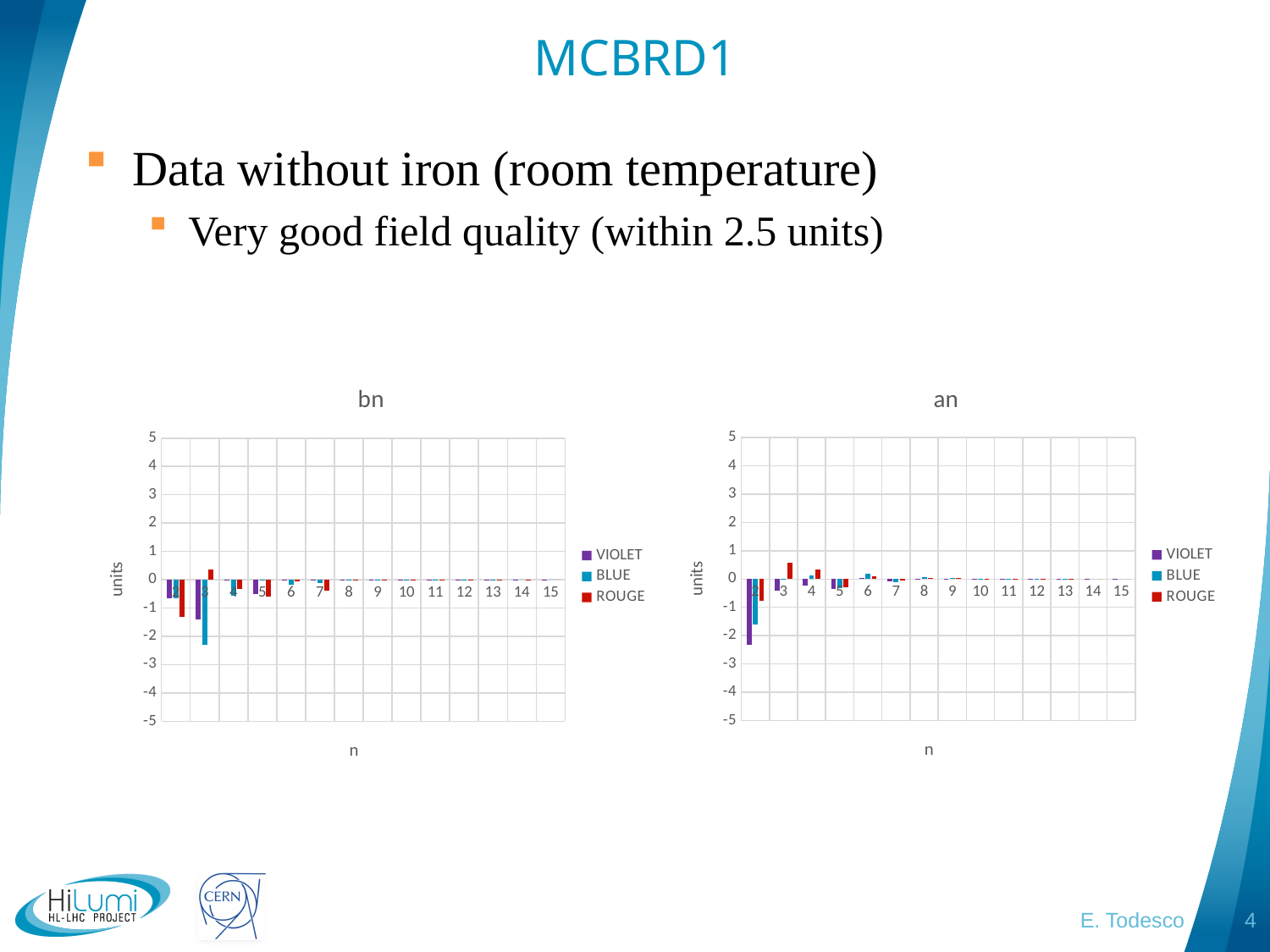
In the chart titled "bn", at n = 3, which is larger: the BLUE value or the ROUGE value? ROUGE In the chart titled "an", what is the label of the x axis? n In the chart titled "bn", what is the label of the y axis? units In the chart titled "bn", is the ROUGE value at n = 2 greater or less than -1? less What kind of chart is the chart titled "bn"? bar chart In the chart titled "an", is the BLUE value at n = 2 greater or less than -1? less In the chart titled "an", is the VIOLET value at n = 2 greater or less than -2? less In the chart titled "bn", which series has the lowest value at n = 3? BLUE How many series does the legend of the chart titled "an" list? 3 In the chart titled "an", do the bars generally get larger or smaller in magnitude as n increases? smaller In the chart titled "an", which series has the lowest value at n = 2? VIOLET